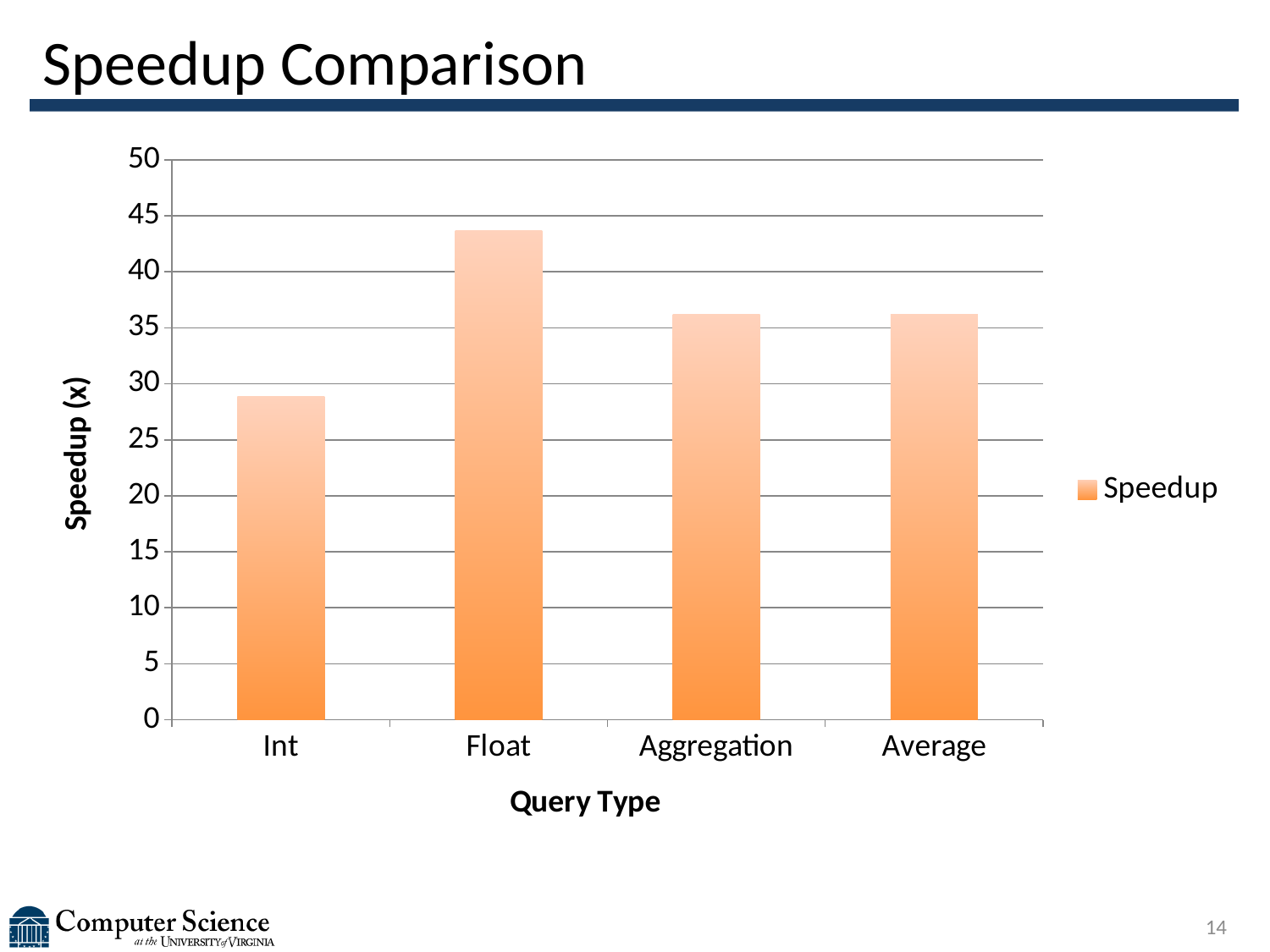
Is the speedup for Float greater or less than 40? greater Is the speedup for Aggregation greater or less than 35? greater Which has a larger speedup, Float or Int? Float How many series does the legend list? 1 Which query type has the lowest speedup? Int What kind of chart is shown on the slide? bar chart Which query type has the highest speedup? Float Which has a larger speedup, Aggregation or Float? Float What is the label of the y axis? Speedup (x) What is the label of the x axis? Query Type How many query types are plotted on the x axis? 4 Is the speedup for Int greater or less than 30? less